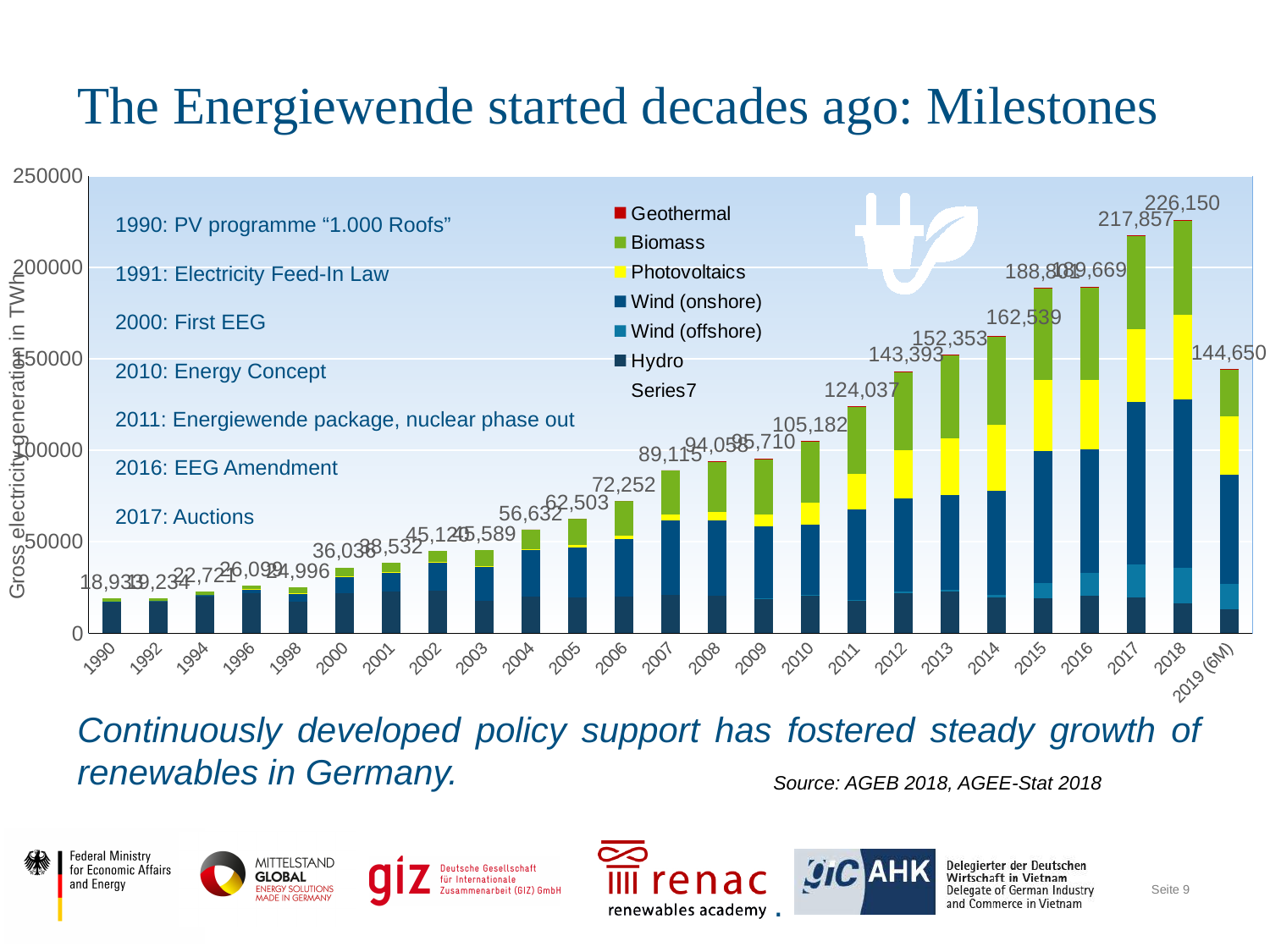
Which has the larger total, 2017 or 2019 (6M)? 2017 What is the total value labelled for 2006? 72,252 What is the total value labelled for 2019 (6M)? 144,650 How many series does the legend list? 7 What is the difference between the total values for 2018 and 2017? 8,293 What is the total value labelled for 2011? 124,037 Which year has the highest total gross electricity generation? 2018 What is the difference between the total values for 2012 and 2011? 19,356 Do the total values generally rise or fall from 1990 to 2018? Rise What is the total gross electricity generation labelled for 2018? 226,150 What kind of chart is shown on the slide? Stacked bar chart Is the total value for 2014 greater or less than 150000? greater